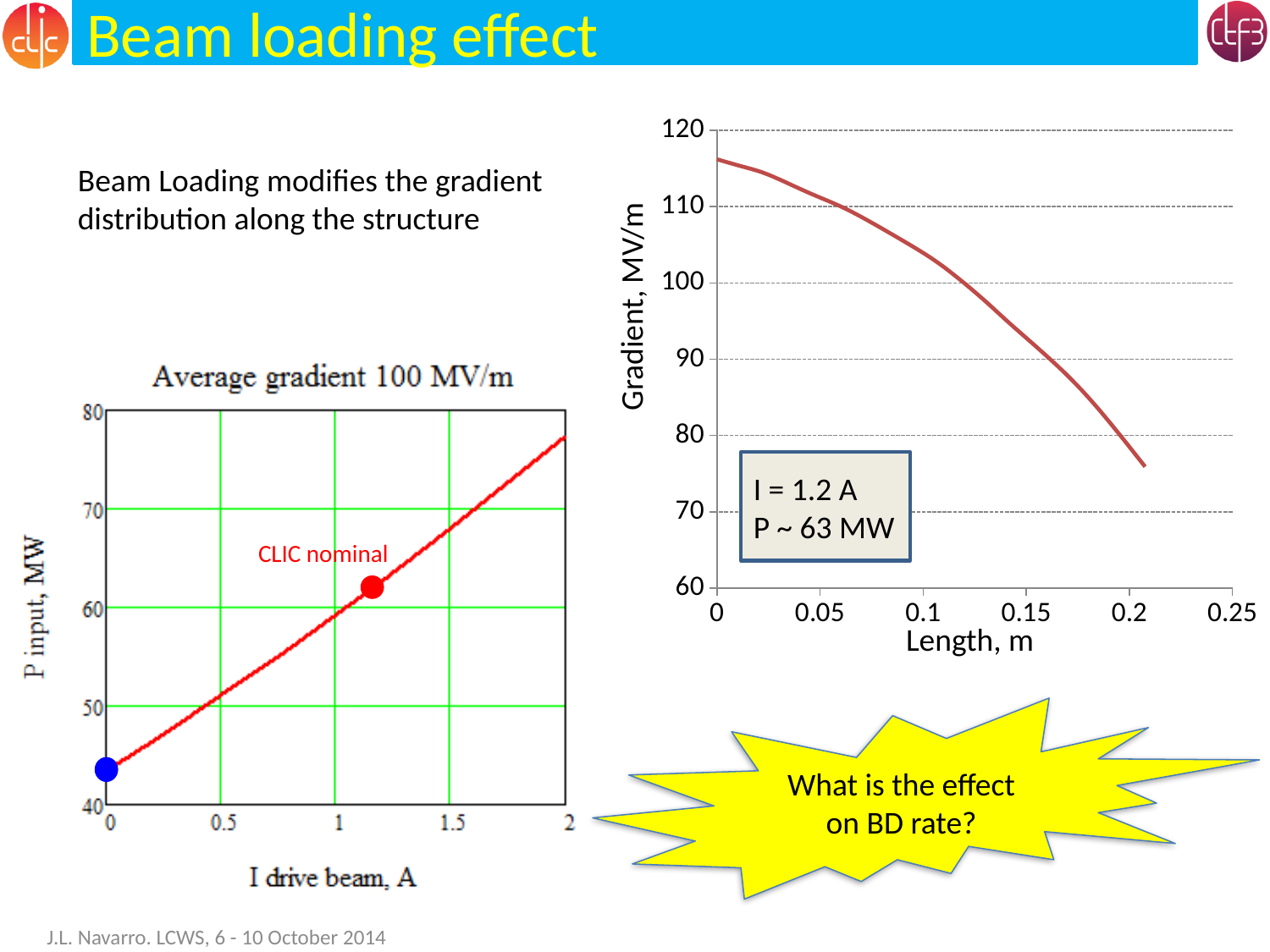
In the left-hand chart 'Average gradient 100 MV/m', which is larger: P input at I drive beam = 0 A or at I drive beam = 2 A? 2 A What kind of chart is the chart on the right titled with axes 'Gradient, MV/m' and 'Length, m'? line chart In the right-hand chart (Gradient vs Length), is the gradient at Length 0.1 m greater or less than 110? less In the right-hand chart (Gradient vs Length), is the gradient at Length 0 m greater or less than 110? greater What is the y-axis label of the right-hand chart? Gradient, MV/m In the left-hand chart 'Average gradient 100 MV/m', is P input at I drive beam = 2 A greater or less than 70? greater In the left-hand chart 'Average gradient 100 MV/m', do the values rise or fall as I drive beam increases? rise What is the title of the chart on the left? Average gradient 100 MV/m In the right-hand chart (Gradient vs Length), do the values rise or fall as Length increases? fall